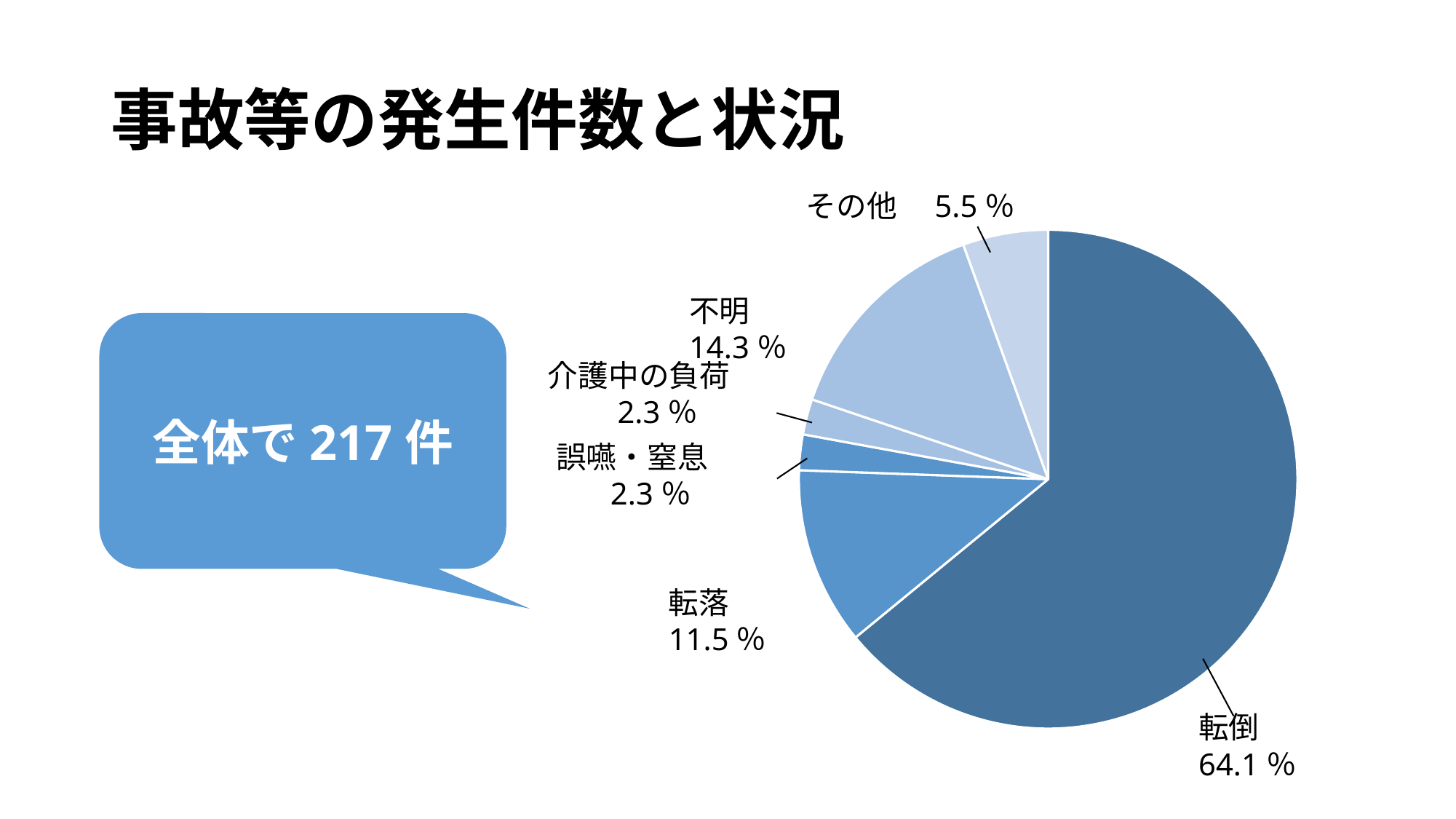
Which is larger, the share for 不明 or the share for 転落? 不明 What share of the pie does 不明 account for? 14.3 % What is the difference in percentage points between 転倒 and 不明? 49.8 What share of the pie does 転落 account for? 11.5 % What share of the pie does 転倒 account for? 64.1 % How many slices does the pie chart have? 6 What total number of cases does the callout on the slide state? 217 件 What kind of chart is shown on the slide? pie chart What share of the pie does 誤嚥・窒息 account for? 2.3 % What is the difference in percentage points between 転落 and その他? 6.0 Which category has the largest slice of the pie? 転倒 What share of the pie does その他 account for? 5.5 %